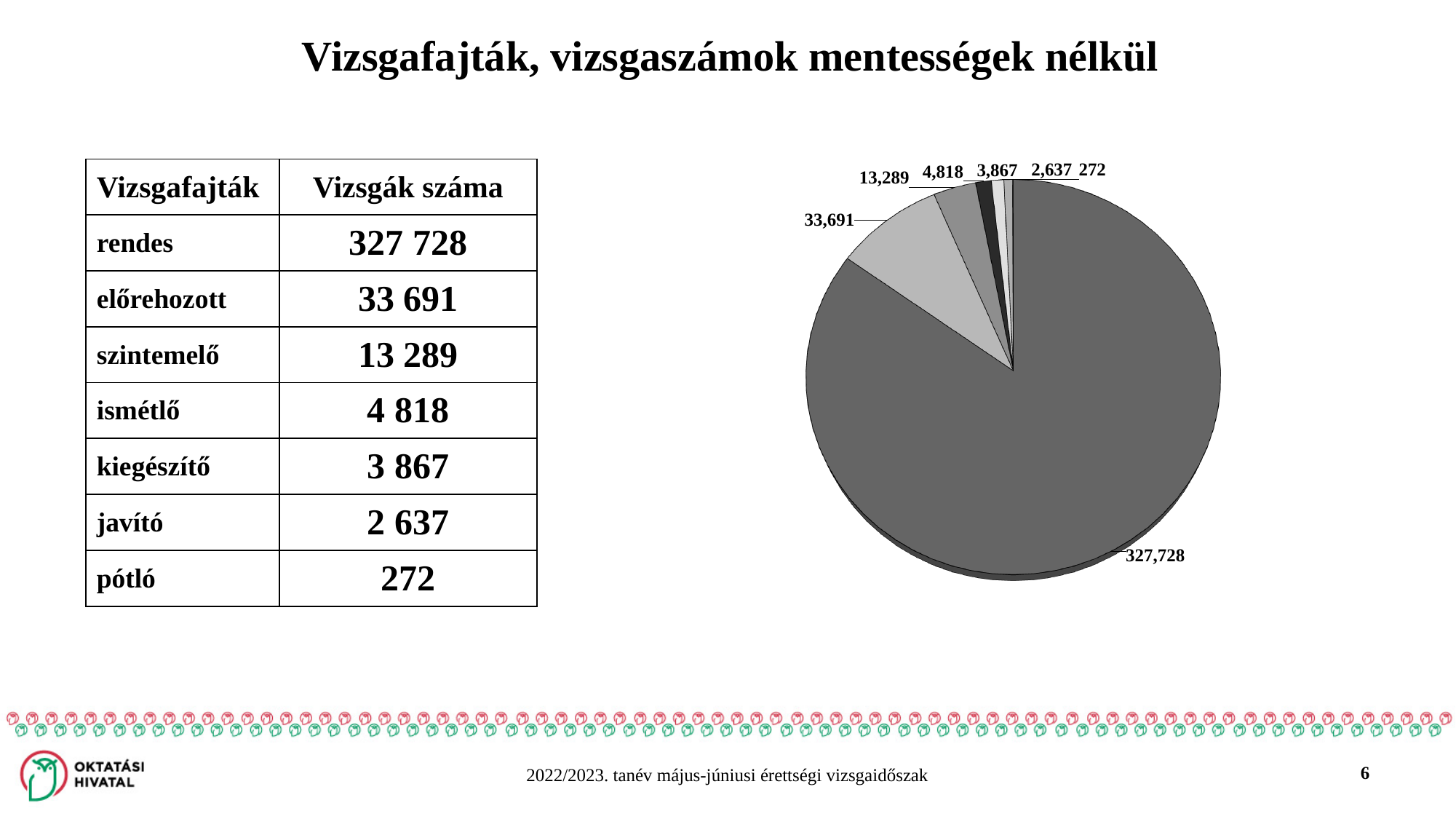
What is the value shown for the 'szintemelő' exam type? 13 289 How many slices does the pie chart have? 7 What is the value of the second-largest slice in the pie chart? 33,691 What is the title of the slide containing the pie chart? Vizsgafajták, vizsgaszámok mentességek nélkül What is the difference between the 4,818 slice and the 3,867 slice in the pie chart? 951 Which exam type (vizsgafajta) has the largest slice in the pie chart? rendes What is the value of the smallest slice in the pie chart? 272 What kind of chart is shown on the slide? pie chart What is the difference between the 33,691 slice and the 13,289 slice in the pie chart? 20,402 Which exam type (vizsgafajta) has the smallest slice in the pie chart? pótló What is the value of the largest slice in the pie chart? 327,728 Which is larger in the pie chart: the slice for 'ismétlő' or the slice for 'kiegészítő'? ismétlő